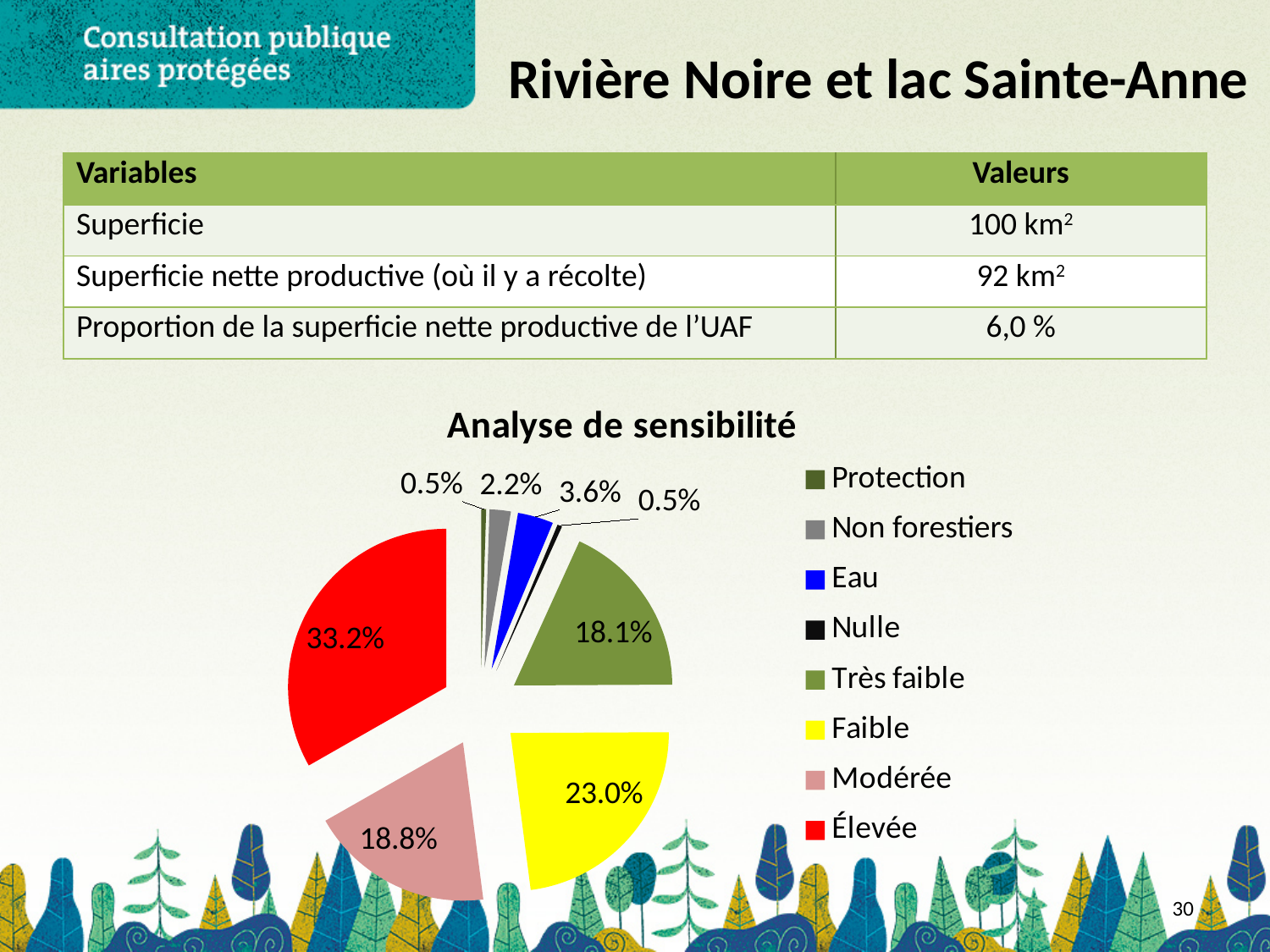
How many categories does the legend of the "Analyse de sensibilité" pie chart list? 8 In the "Analyse de sensibilité" pie chart, what share is labelled for Eau? 3.6% What kind of chart is shown under the title "Analyse de sensibilité"? pie chart In the "Analyse de sensibilité" pie chart, what colour is the Élevée slice? red In the "Analyse de sensibilité" pie chart, what share is labelled for Non forestiers? 2.2% In the "Analyse de sensibilité" pie chart, what share is labelled for Très faible? 18.1% Which category has the largest slice in the "Analyse de sensibilité" pie chart? Élevée In the "Analyse de sensibilité" pie chart, what share is labelled for Élevée? 33.2% In the "Analyse de sensibilité" pie chart, what share is labelled for Faible? 23.0% In the "Analyse de sensibilité" pie chart, what share is labelled for Modérée? 18.8% In the "Analyse de sensibilité" pie chart, what is the difference between the Élevée share and the Faible share? 10.2% In the "Analyse de sensibilité" pie chart, which slice is larger: Faible or Modérée? Faible